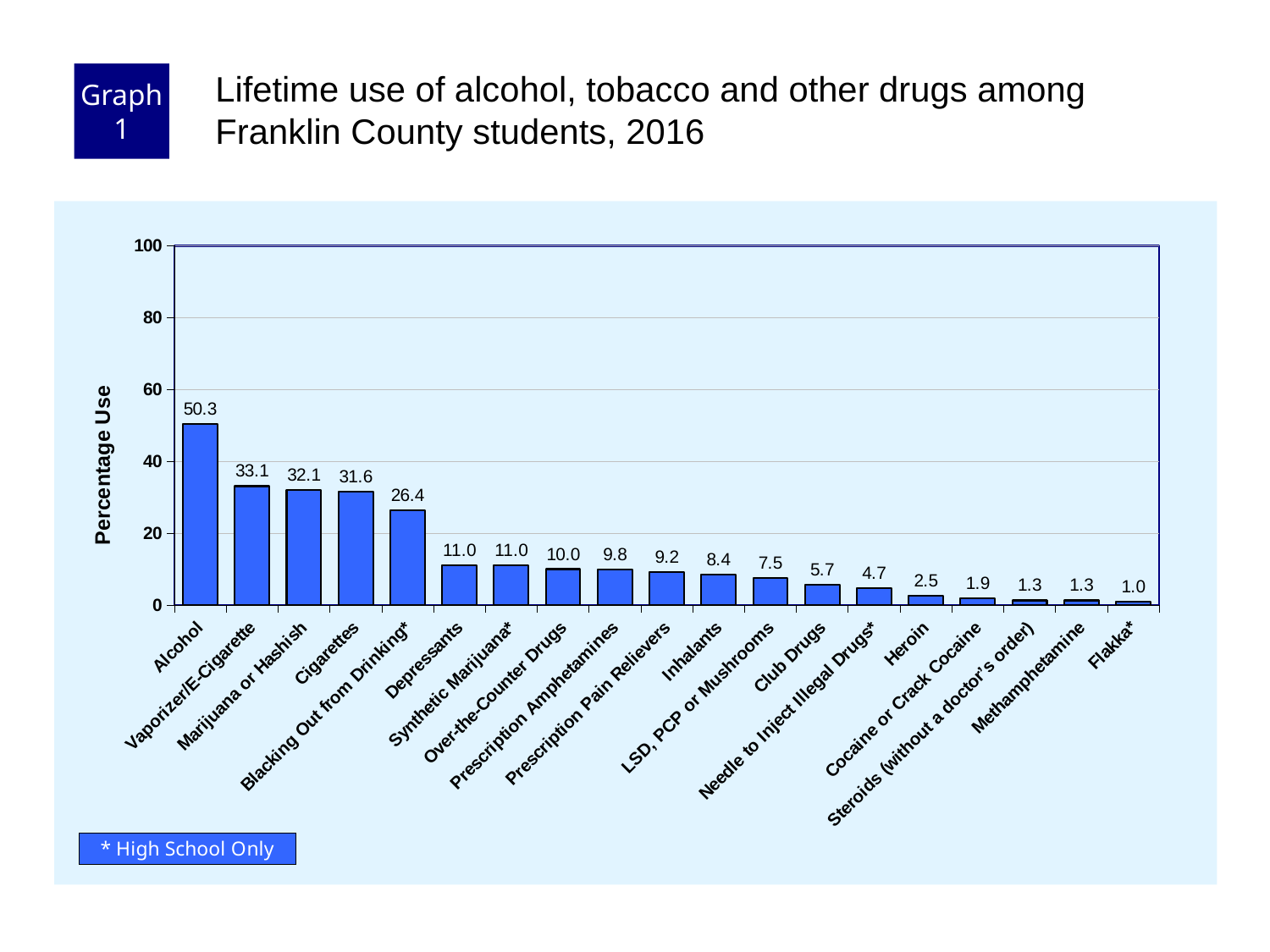
How many categories are shown on the chart? 19 Which category has the highest percentage use? Alcohol What is the percentage use for Vaporizer/E-Cigarette? 33.1 What is the percentage use for Club Drugs? 5.7 Is the value for Blacking Out from Drinking* greater or less than 20? greater What is the percentage use for Alcohol? 50.3 What is the difference in percentage use between Alcohol and Cigarettes? 18.7 What kind of chart is shown on the slide? Bar chart What is the label of the vertical axis? Percentage Use Which category has the lowest percentage use? Flakka* Which has a higher percentage use, Marijuana or Hashish or Cigarettes? Marijuana or Hashish What is the percentage use for Heroin? 2.5